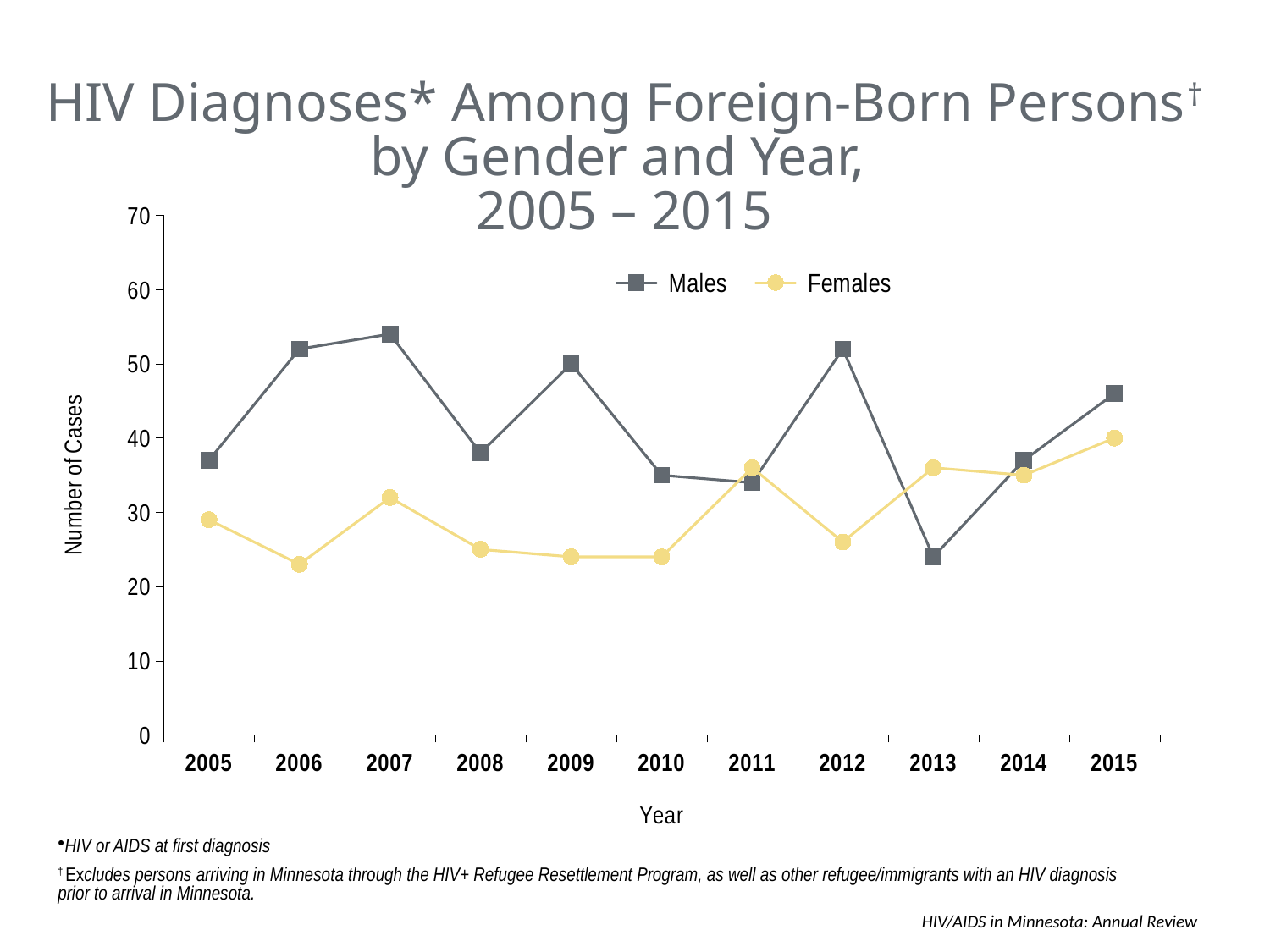
What is the number of cases for Males in 2009? 50 In which year is the Males series at its lowest? 2013 Is the value for Females in 2006 greater or less than 30? less Does the Males series rise or fall from 2007 to 2008? fall What kind of chart is shown on the slide? line chart How many series does the legend list? 2 In 2013, which series has the larger value, Males or Females? Females In which year is the Females series at its highest? 2015 Is the value for Males in 2013 greater or less than 30? less How many years are plotted along the x axis? 11 Is the value for Males in 2007 greater or less than 50? greater What is the number of cases for Females in 2015? 40